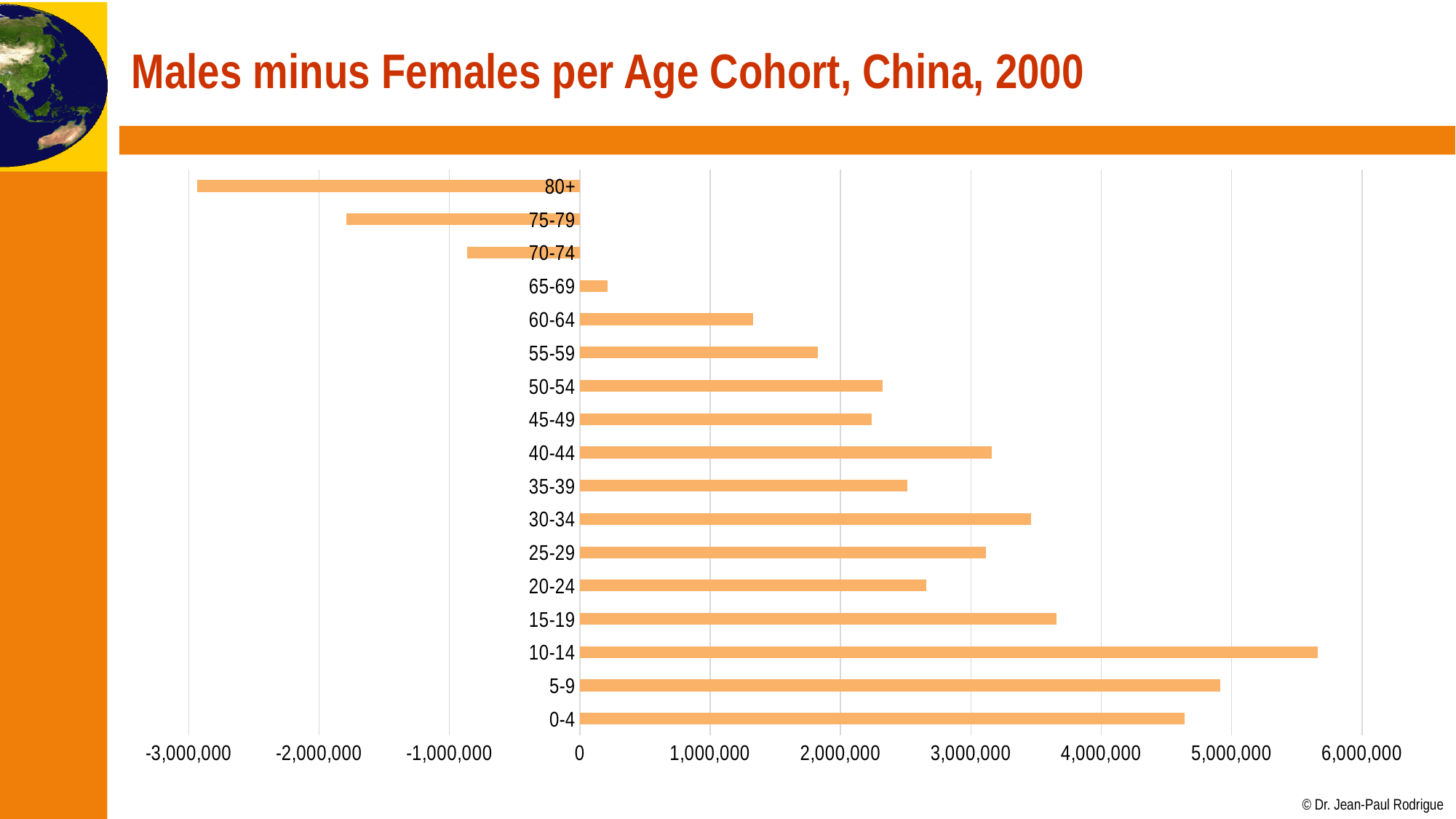
Is the value for the 65-69 cohort greater or less than 1,000,000? less Which cohort has the larger value, 40-44 or 35-39? 40-44 Which age cohort has the lowest value (largest female surplus)? 80+ What is the title of the chart on the slide? Males minus Females per Age Cohort, China, 2000 How many age cohorts are plotted in the chart? 17 Is the value for the 0-4 cohort greater or less than 4,000,000? greater What kind of chart is shown on the slide? Bar chart Which age cohort has the highest value (largest male surplus)? 10-14 Is the value for the 80+ cohort greater or less than -2,000,000? less How many age cohorts have a negative value (more females than males)? 3 Which cohort has the larger value, 10-14 or 5-9? 10-14